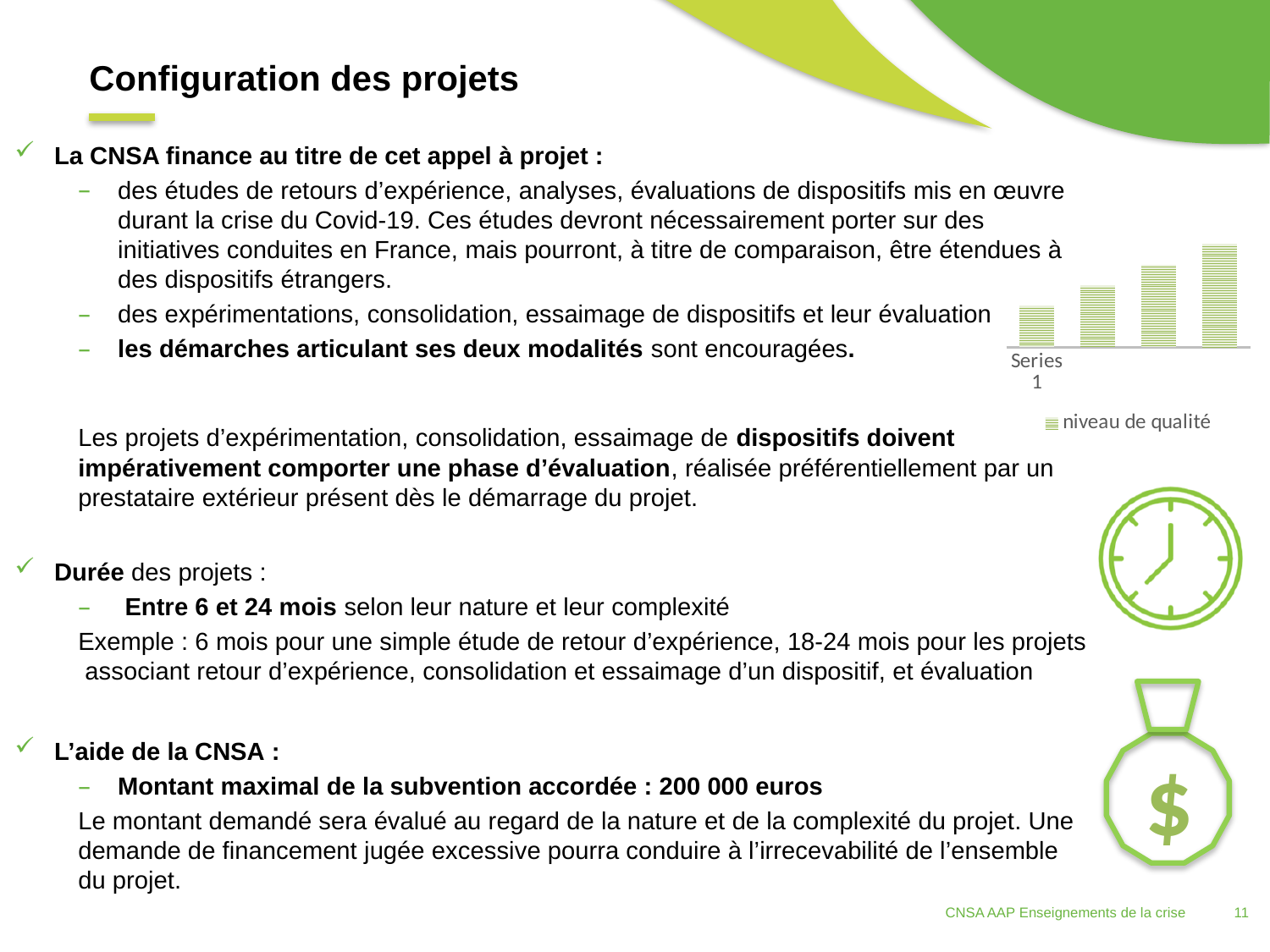
What kind of chart is shown on the right side of the slide? bar chart How many bars does the chart on the slide show? 4 Which bar in the chart is the tallest, the leftmost or the rightmost? the rightmost What label appears on the horizontal axis of the chart? Series 1 Which bar in the chart is the shortest, the leftmost or the rightmost? the leftmost Is the second bar from the left taller or shorter than the third bar from the left? shorter Do the bars in the chart rise or fall from left to right? rise How many series does the chart's legend list? 1 What is the legend entry of the chart on the slide? niveau de qualité